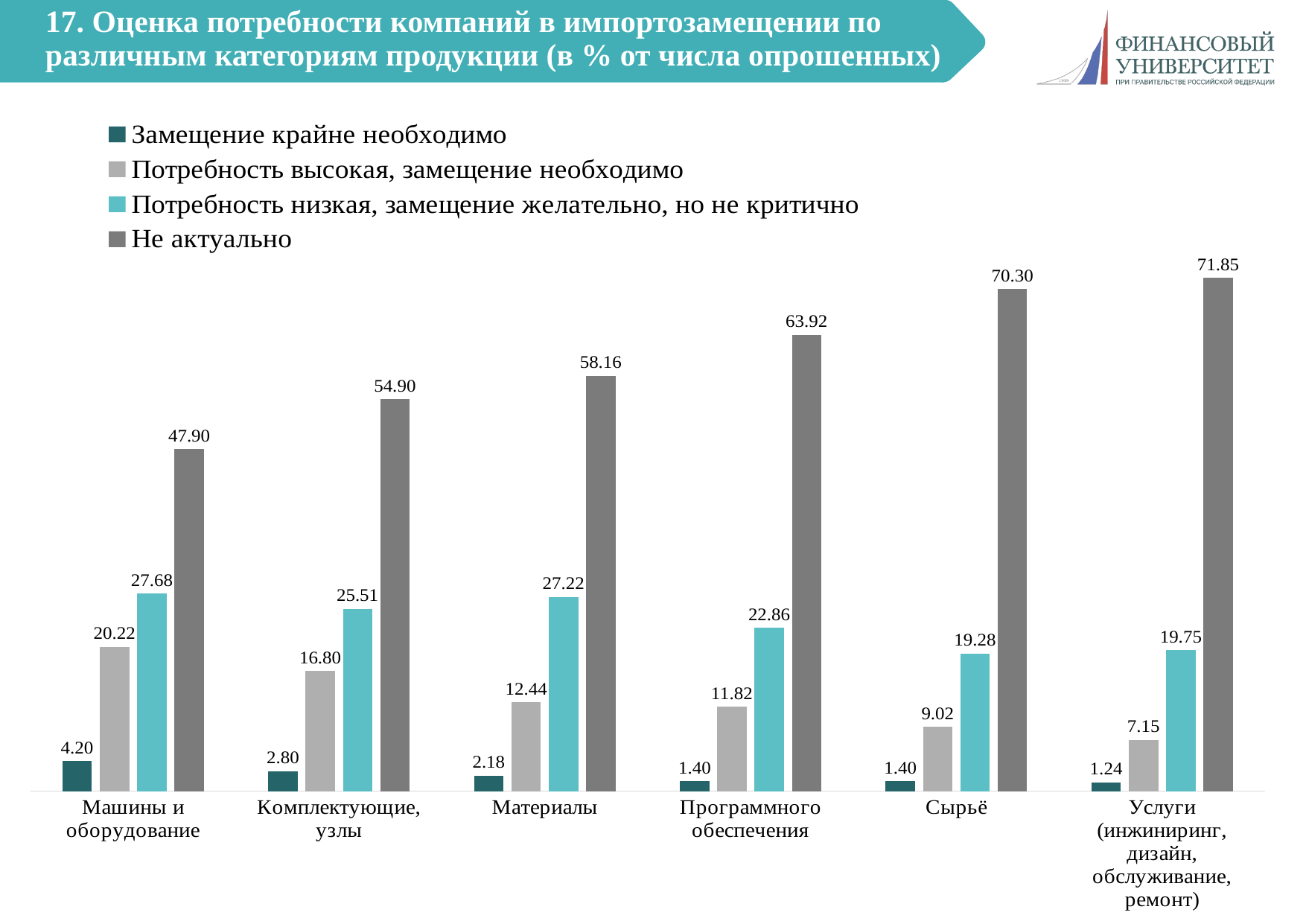
Which category has the lowest value for "Потребность высокая, замещение необходимо"? Услуги (инжиниринг, дизайн, обслуживание, ремонт) How many product categories are shown on the x axis? 6 What is the value of "Потребность низкая, замещение желательно, но не критично" for "Программного обеспечения"? 22.86 Which is larger: the "Потребность низкая, замещение желательно, но не критично" value for "Машины и оборудование" or for "Материалы"? Машины и оборудование What type of chart is shown on the slide? Bar chart What is the difference between the "Не актуально" values for "Услуги" and "Машины и оборудование"? 23.95 What is the value of "Замещение крайне необходимо" for "Машины и оборудование"? 4.20 Which category has the highest value for "Не актуально"? Услуги (инжиниринг, дизайн, обслуживание, ремонт) What is the value of "Потребность высокая, замещение необходимо" for "Материалы"? 12.44 How many series does the legend list? 4 Does the value of "Не актуально" rise or fall from "Машины и оборудование" to "Услуги" along the x axis? Rise What is the value of "Не актуально" for "Сырьё"? 70.30